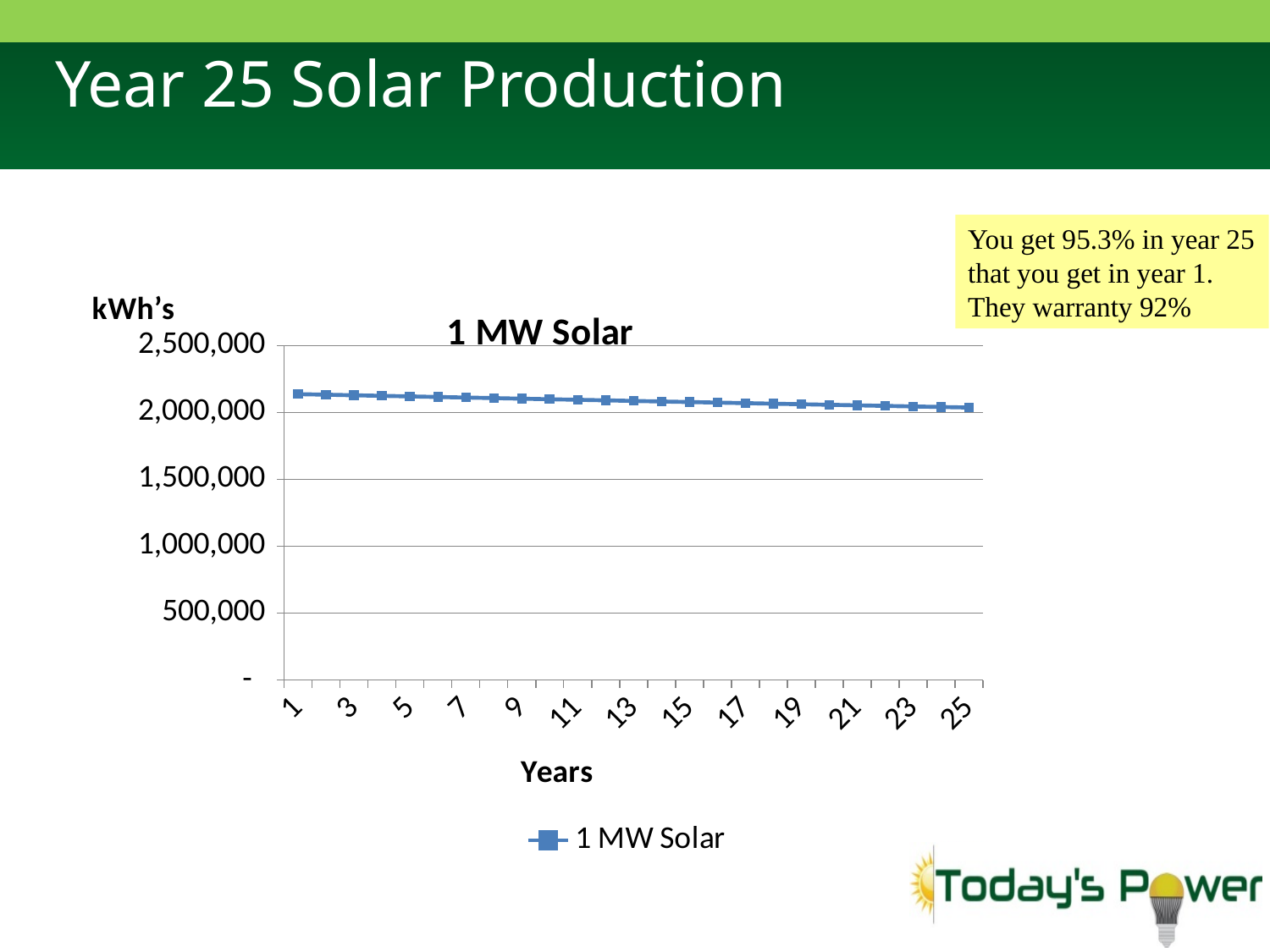
How many series does the chart legend list? 1 Do the values for 1 MW Solar rise or fall as the years increase? fall What kind of chart is shown on the slide? line chart Is the value for year 1 greater or less than 2,000,000? greater Is the value for year 25 greater or less than 1,500,000? greater How many years (data points) are plotted on the chart? 25 Which year has the lowest 1 MW Solar production? 25 Which year has the highest 1 MW Solar production? 1 Which is larger, the value for year 1 or the value for year 25? year 1 What is the label on the x axis of the chart? Years Is the value for year 1 greater or less than 2,500,000? less What is the title of the chart? 1 MW Solar